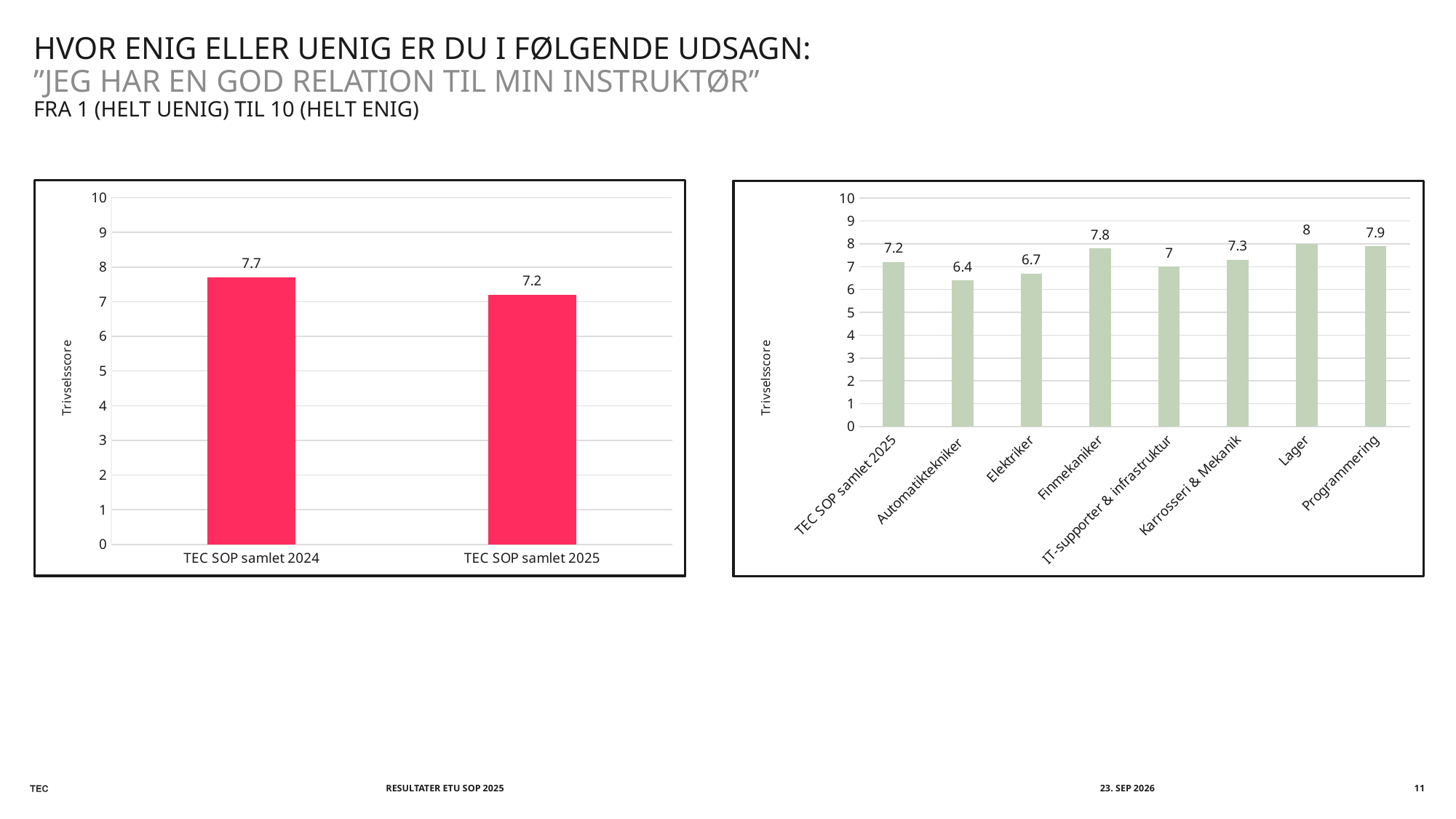
In the right chart, how many categories are shown? 8 In the right chart, which category has the lowest value? Automatiktekniker In the left chart, what is the value for TEC SOP samlet 2024? 7.7 In the right chart, which category has the highest value? Lager In the right chart, what is the value for Automatiktekniker? 6.4 What type of chart is the right chart? bar chart In the left chart, do the values rise or fall from 2024 to 2025? fall In the left chart, what is the difference between TEC SOP samlet 2024 and TEC SOP samlet 2025? 0.5 In the right chart, what is the difference between Programmering and IT-supporter & infrastruktur? 0.9 In the right chart, what is the value for Finmekaniker? 7.8 In the left chart, what is the value for TEC SOP samlet 2025? 7.2 In the right chart, which is larger, Elektriker or Karrosseri & Mekanik? Karrosseri & Mekanik